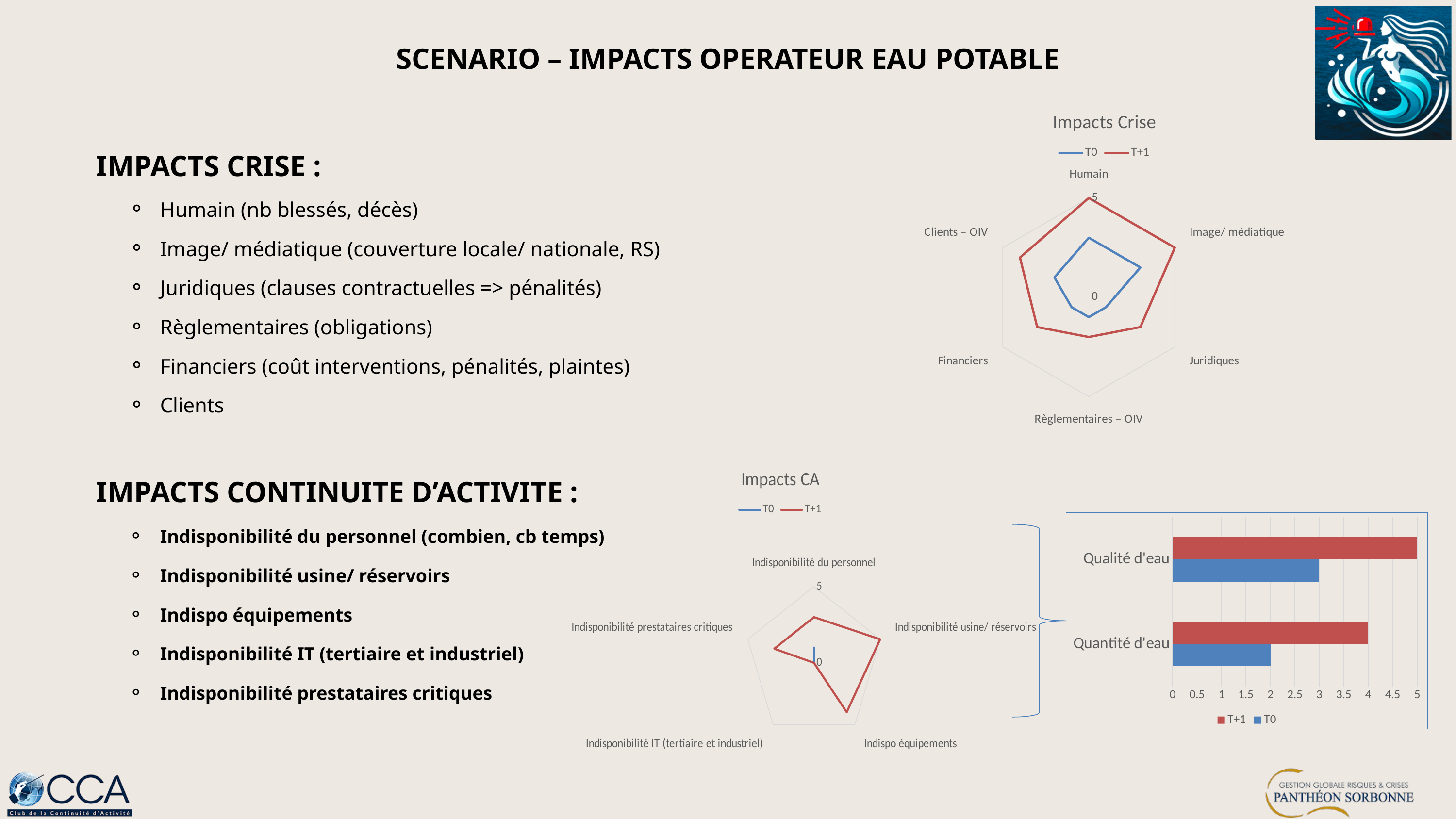
In the bar chart at the bottom right, is the T0 value for Qualité d'eau larger or smaller than the T0 value for Quantité d'eau? larger In the bar chart at the bottom right, which category has the higher T+1 value? Qualité d'eau How many categories does the 'Impacts CA' chart have? 5 In the bar chart at the bottom right, what is the T+1 value for Qualité d'eau? 5 In the bar chart at the bottom right, what is the T0 value for Qualité d'eau? 3 In the 'Impacts Crise' chart, which series has the larger value for Humain, T0 or T+1? T+1 In the bar chart at the bottom right, what is the difference between the T+1 and T0 values for Quantité d'eau? 2 In the bar chart at the bottom right, what is the T0 value for Quantité d'eau? 2 How many categories does the 'Impacts Crise' chart have? 6 How many series does the legend of the bar chart at the bottom right list? 2 What kind of chart is the 'Impacts Crise' chart? radar chart What kind of chart is the chart at the bottom right of the slide? bar chart